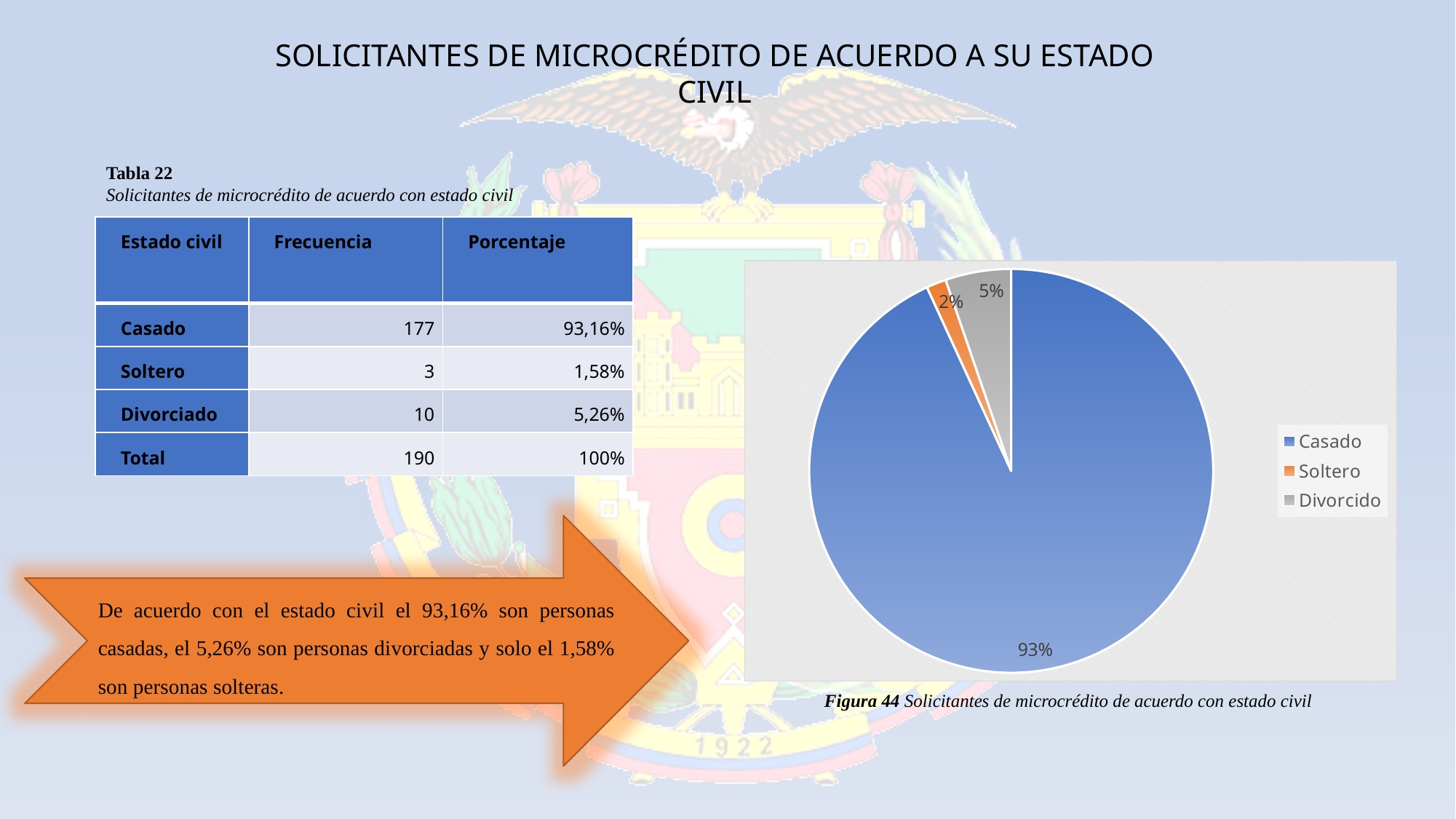
How many slices does the pie chart have? 3 How many entries does the pie chart's legend list? 3 What share of the pie chart does Divorciado represent? 5% Which category has the largest slice in the pie chart? Casado What share of the pie chart does Casado represent? 93% What colour is the Soltero slice in the pie chart? orange What is the difference in percentage points between the Casado and Divorciado slices in the pie chart? 88% What kind of chart is shown on the slide? pie chart What is the figure caption below the pie chart? Figura 44 Solicitantes de microcrédito de acuerdo con estado civil Which category has the smallest slice in the pie chart? Soltero What share of the pie chart does Soltero represent? 2% Which slice is larger in the pie chart, Divorciado or Soltero? Divorciado